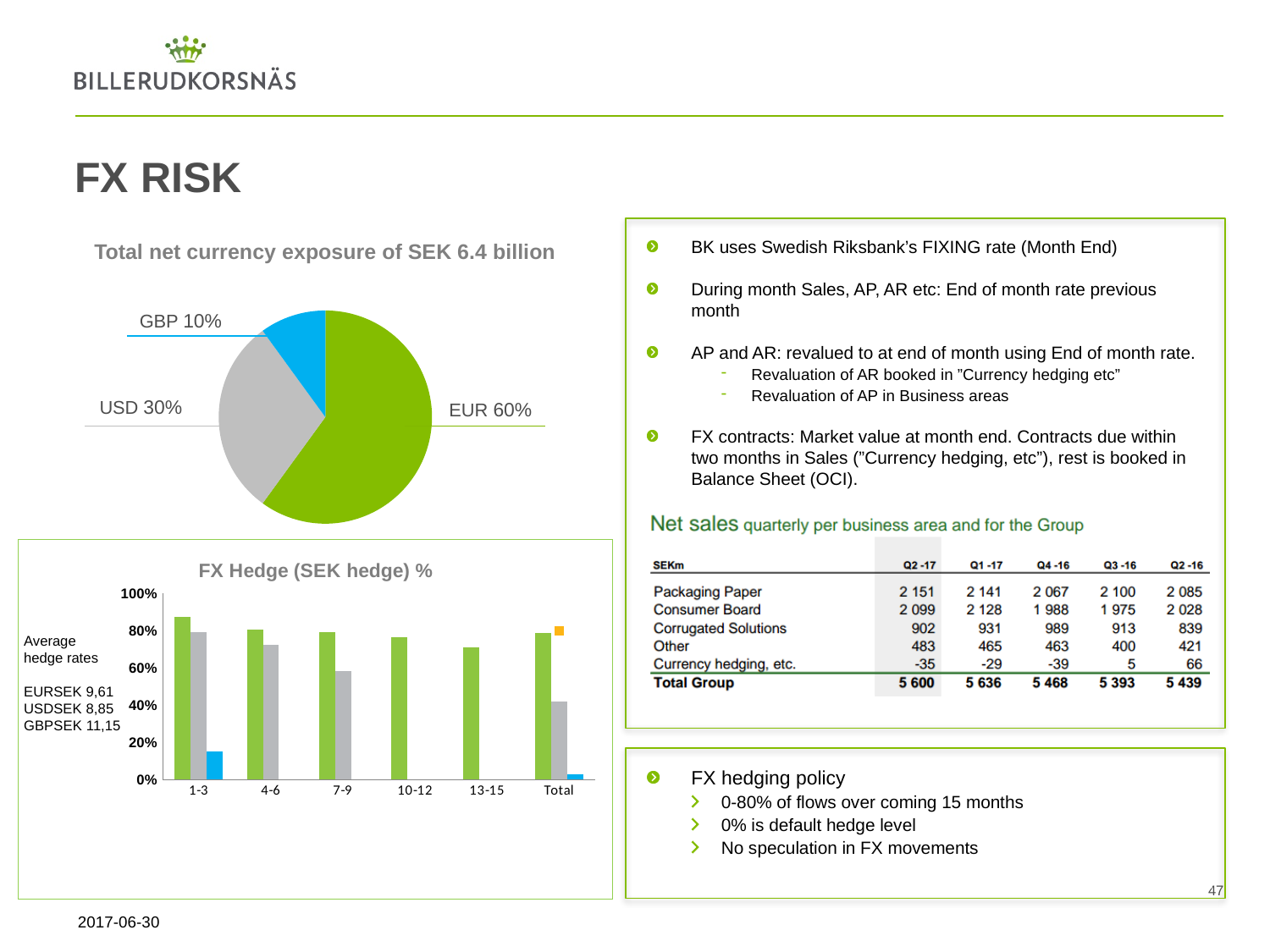
In the pie chart 'Total net currency exposure of SEK 6.4 billion', what share does USD have? 30% In the chart 'FX Hedge (SEK hedge) %', is the green bar for 1-3 greater or less than 80%? greater In the pie chart 'Total net currency exposure of SEK 6.4 billion', how many slices are there? 3 In the chart 'FX Hedge (SEK hedge) %', is the grey bar for Total greater or less than 60%? less In the chart 'FX Hedge (SEK hedge) %', is the blue bar for 1-3 greater or less than 20%? less In the pie chart 'Total net currency exposure of SEK 6.4 billion', how many percentage points larger is the EUR share than the USD share? 30 In the chart 'FX Hedge (SEK hedge) %', how many categories are shown on the x axis? 6 What kind of chart is 'FX Hedge (SEK hedge) %'? bar chart In the pie chart 'Total net currency exposure of SEK 6.4 billion', which currency has the largest share? EUR In the pie chart 'Total net currency exposure of SEK 6.4 billion', what share does EUR have? 60% What kind of chart is 'Total net currency exposure of SEK 6.4 billion'? pie chart In the pie chart 'Total net currency exposure of SEK 6.4 billion', which currency has the smallest share? GBP